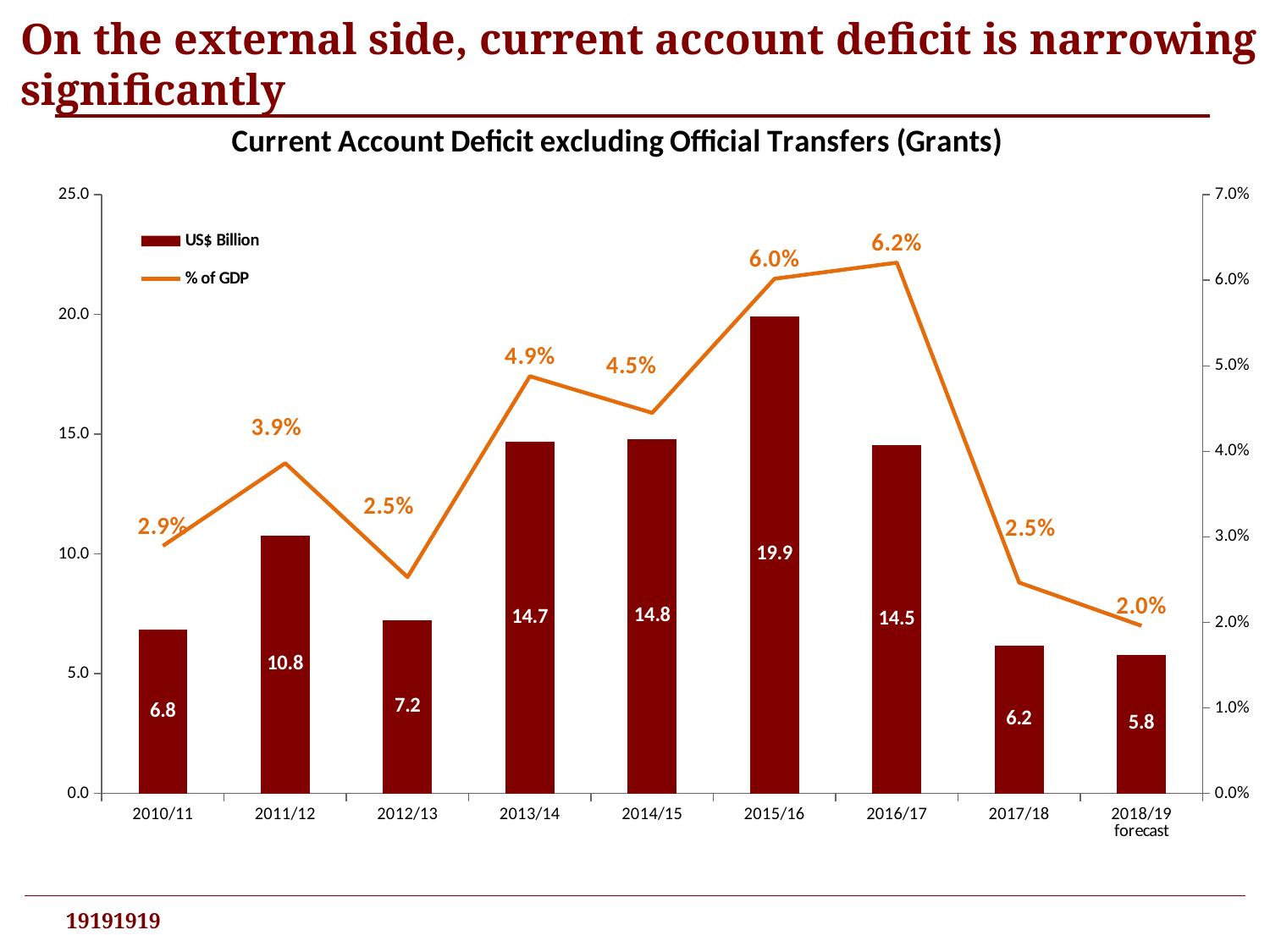
Which year has the highest % of GDP value? 2016/17 What is the title of the chart? Current Account Deficit excluding Official Transfers (Grants) Which is larger in US$ Billion, 2011/12 or 2012/13? 2011/12 What is the difference in US$ Billion between 2015/16 and 2016/17? 5.4 How many series does the legend list? 2 Which year has the lowest US$ Billion value? 2018/19 forecast What is the US$ Billion value for the 2018/19 forecast? 5.8 Does the % of GDP value rise or fall from 2016/17 to 2018/19 forecast? fall What is the US$ Billion value for 2015/16? 19.9 Which year has the highest US$ Billion value? 2015/16 How many years are shown on the x axis? 9 What is the % of GDP value for 2016/17? 6.2%